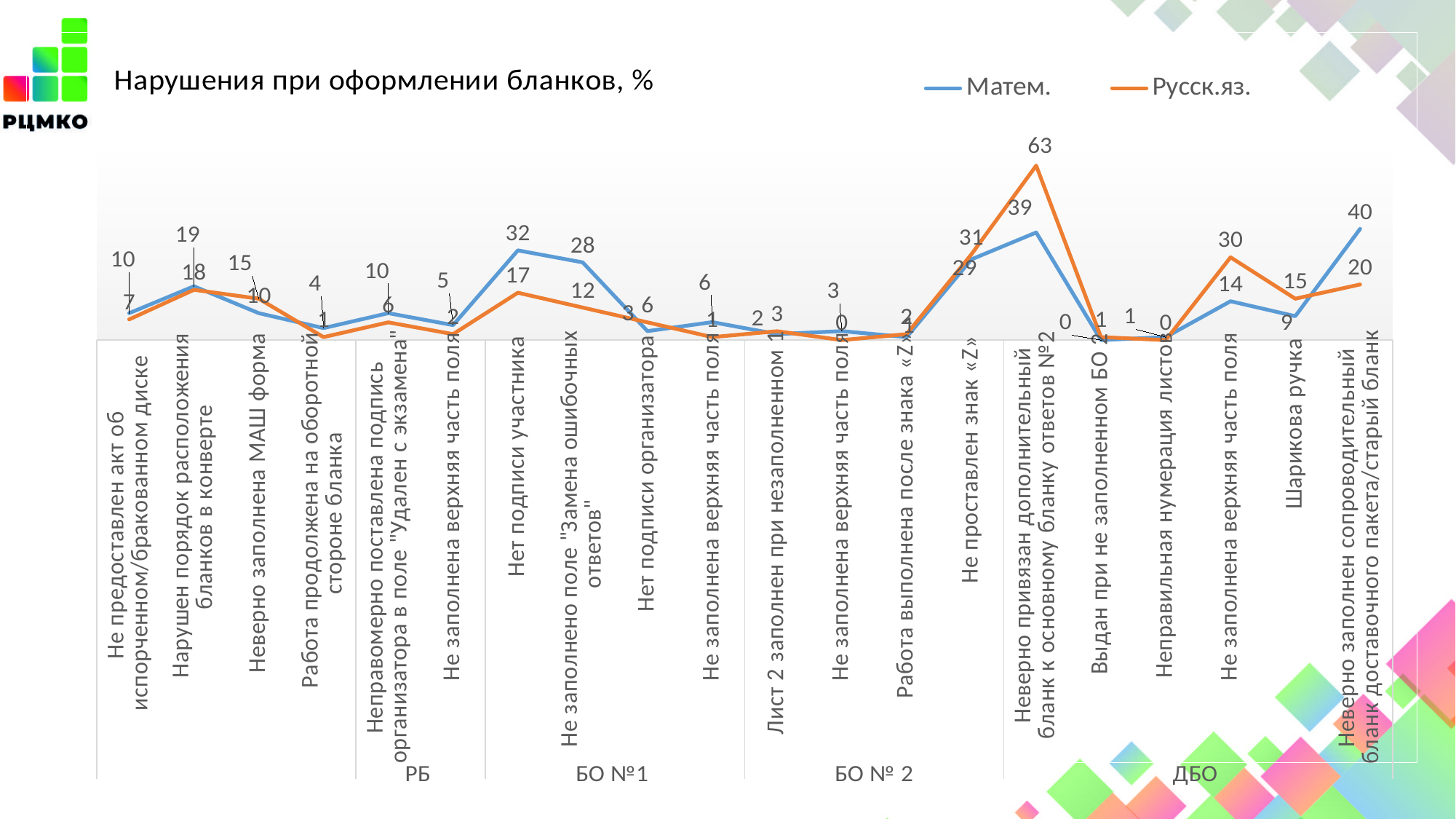
What kind of chart is shown on the slide? line chart Which category has the highest value for Русск.яз.? Неверно привязан дополнительный бланк к основному бланку ответов №2 What is the difference between the Матем. and Русск.яз. values for "Неверно заполнен сопроводительный бланк доставочного пакета/старый бланк"? 20 What is the difference between the Матем. and Русск.яз. values for "Нет подписи участника"? 15 What is the value for Матем. for the category "Не проставлен знак «Z»"? 29 What is the value for Русск.яз. for "Не заполнена верхняя часть поля" in the ДБО group? 30 How many categories are plotted along the x axis? 20 How many series does the legend list? 2 What are the two series named in the legend? Матем. and Русск.яз. What is the value for Русск.яз. for the category "Неверно привязан дополнительный бланк к основному бланку ответов №2"? 63 What is the value for Матем. for the category "Нет подписи участника"? 32 For "Шарикова ручка", which series has the larger value, Матем. or Русск.яз.? Русск.яз.